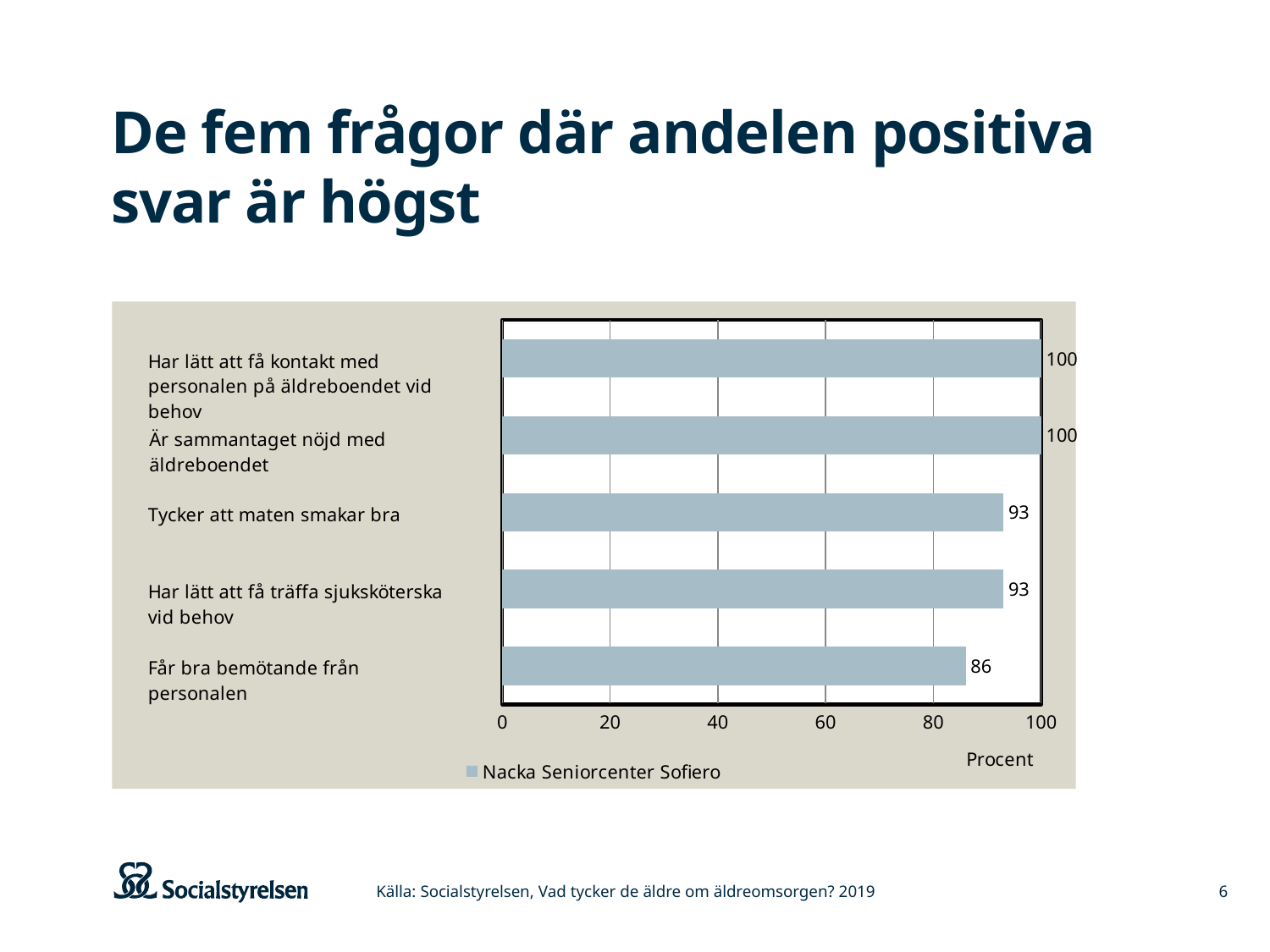
What kind of chart is shown on the slide? Bar chart How many categories are shown in the chart? 5 What is the value for "Tycker att maten smakar bra"? 93 What is the difference between the value for "Är sammantaget nöjd med äldreboendet" and the value for "Får bra bemötande från personalen"? 14 What is the value for "Har lätt att få träffa sjuksköterska vid behov"? 93 Which category has the lowest value? Får bra bemötande från personalen What is the value for "Får bra bemötande från personalen"? 86 What series name is shown in the chart legend? Nacka Seniorcenter Sofiero Which is larger: the value for "Har lätt att få träffa sjuksköterska vid behov" or the value for "Får bra bemötande från personalen"? Har lätt att få träffa sjuksköterska vid behov How many series does the legend list? 1 What is the value for "Är sammantaget nöjd med äldreboendet"? 100 What is the difference between the value for "Tycker att maten smakar bra" and the value for "Får bra bemötande från personalen"? 7